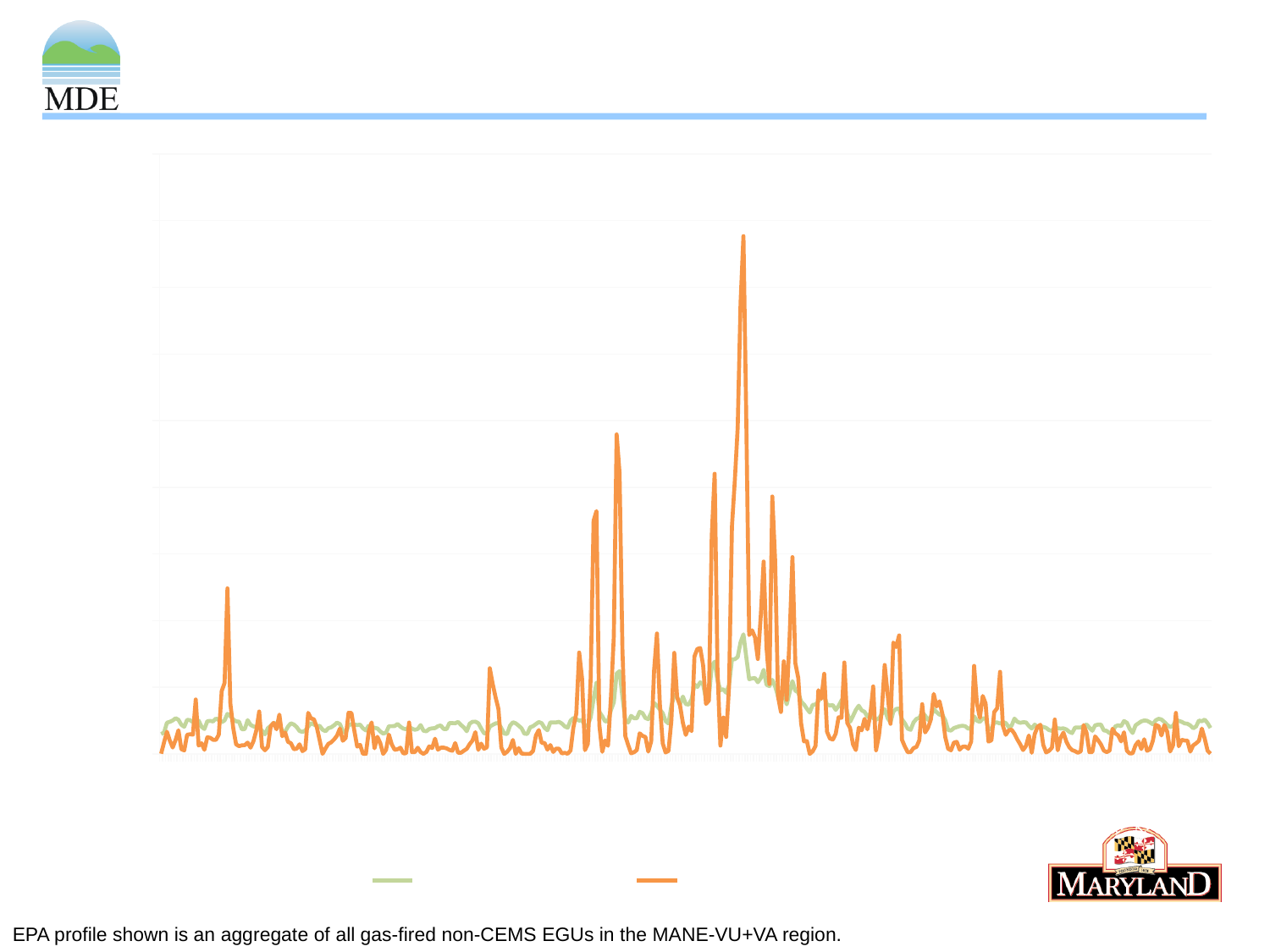
Which line reaches the highest peak on the chart, the green line or the orange line? the orange line What colours are the two lines plotted on the chart? green and orange What kind of chart is shown on the slide? line chart Which line stays flatter across the chart, the green line or the orange line? the green line How many series does the legend below the chart list? 2